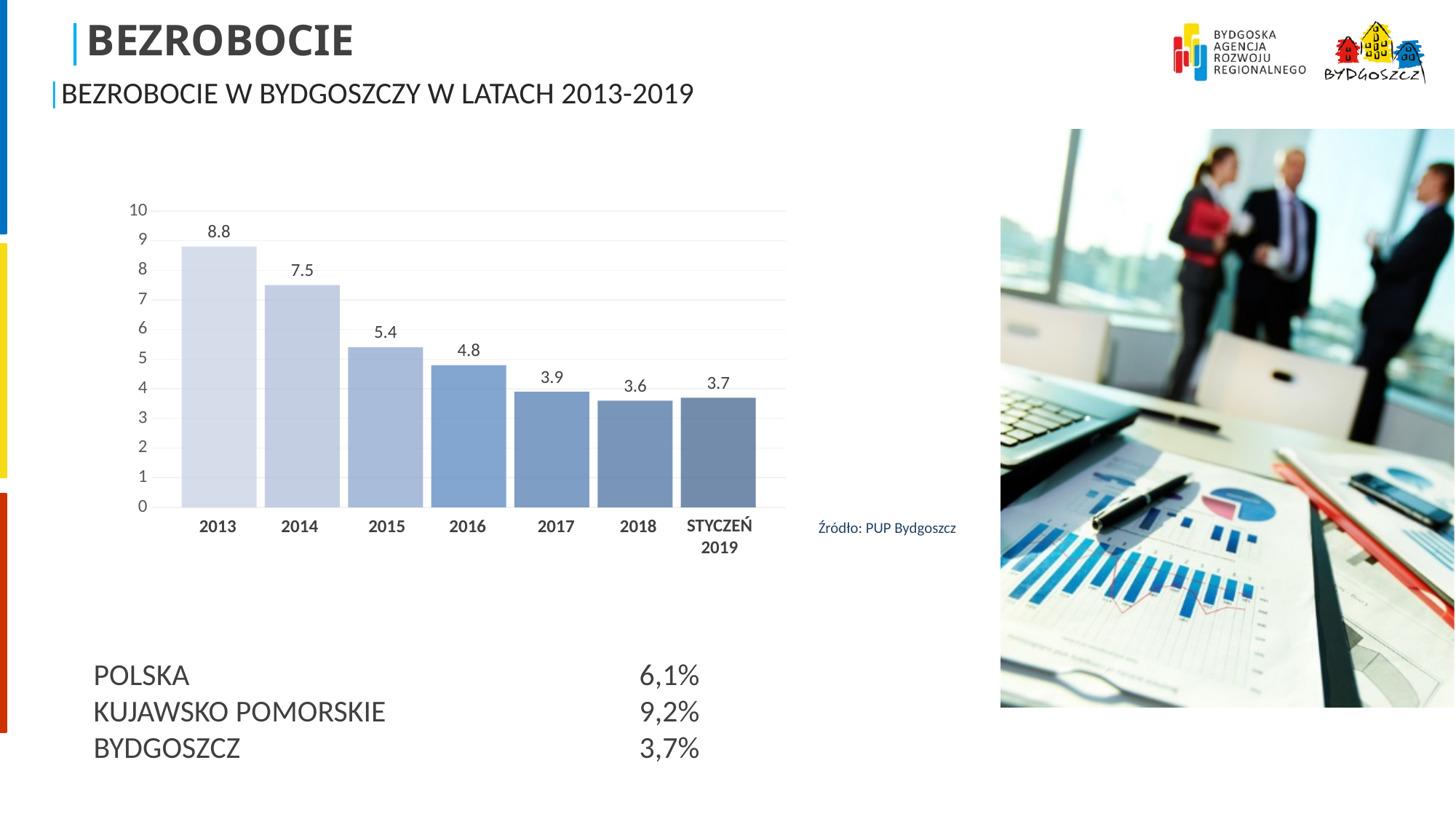
What kind of chart is shown on the slide? bar chart Which year has the highest value in the chart? 2013 Is the value for 2014 greater or less than 7? greater How many bars are shown in the chart? 7 Which category has the lowest value in the chart? 2018 Which is larger, the value for 2017 or the value for 2018? 2017 What is the difference between the values for 2015 and 2018? 1.8 What is the value shown for STYCZEŃ 2019? 3.7 What is the difference between the values for 2013 and 2014? 1.3 Do the values generally rise or fall from 2013 to 2018? fall What is the value shown for 2016? 4.8 What is the unemployment value shown for 2013? 8.8